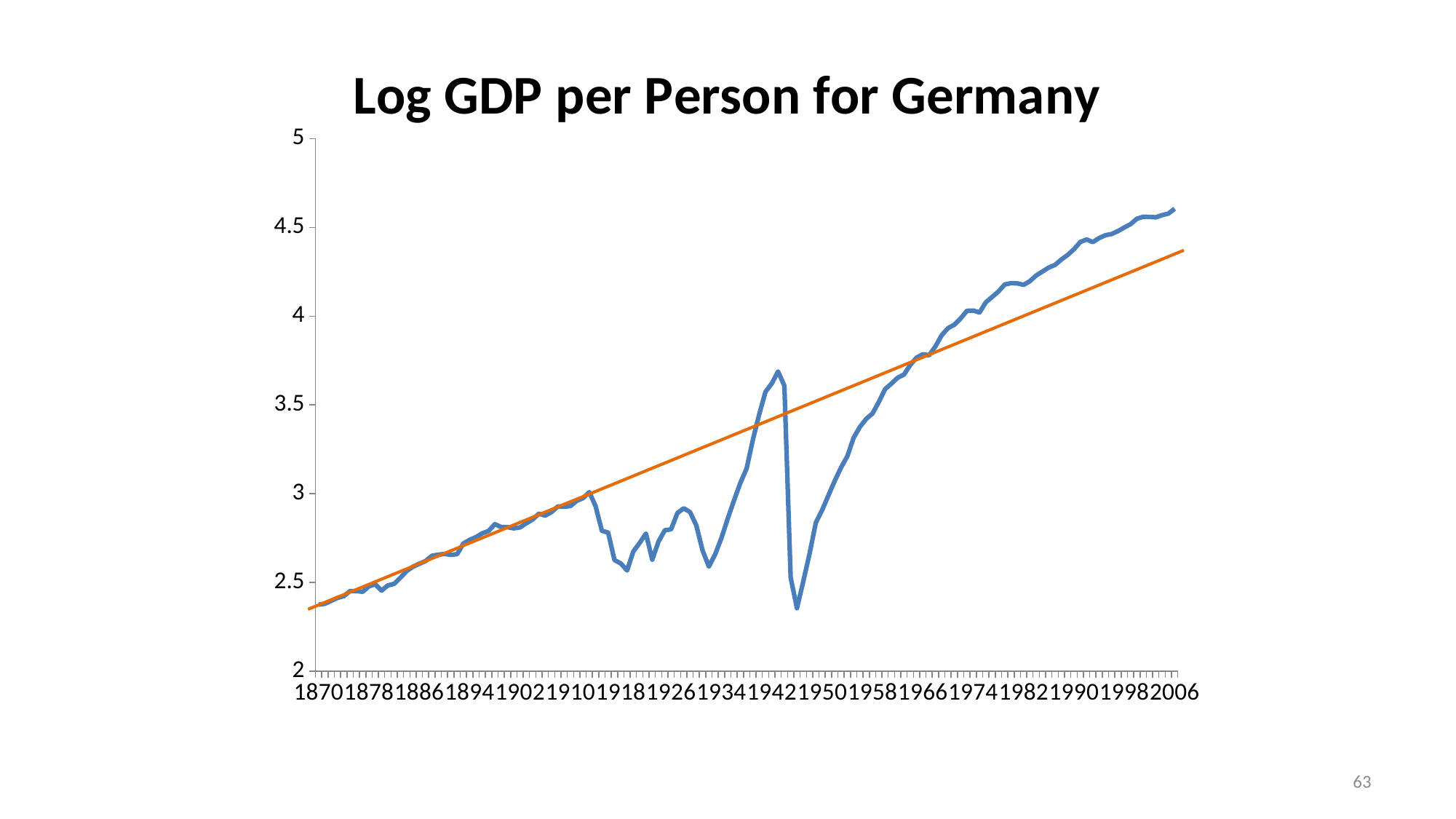
In 1950, is the blue line above or below the orange straight line? below Is the lowest point of the blue line shortly after 1942 greater or less than 2.5? less What is the first year shown on the x axis? 1870 What is the title of the chart? Log GDP per Person for Germany Is the value of the blue line in 2006 greater or less than 4? greater Is the peak of the blue line around 1942 greater or less than 3.5? greater In 2006, is the blue line above or below the orange straight line? above Overall, does the blue line rise or fall from 1870 to 2006? rise What kind of chart is shown on the slide? line chart How many year labels are shown on the x axis? 18